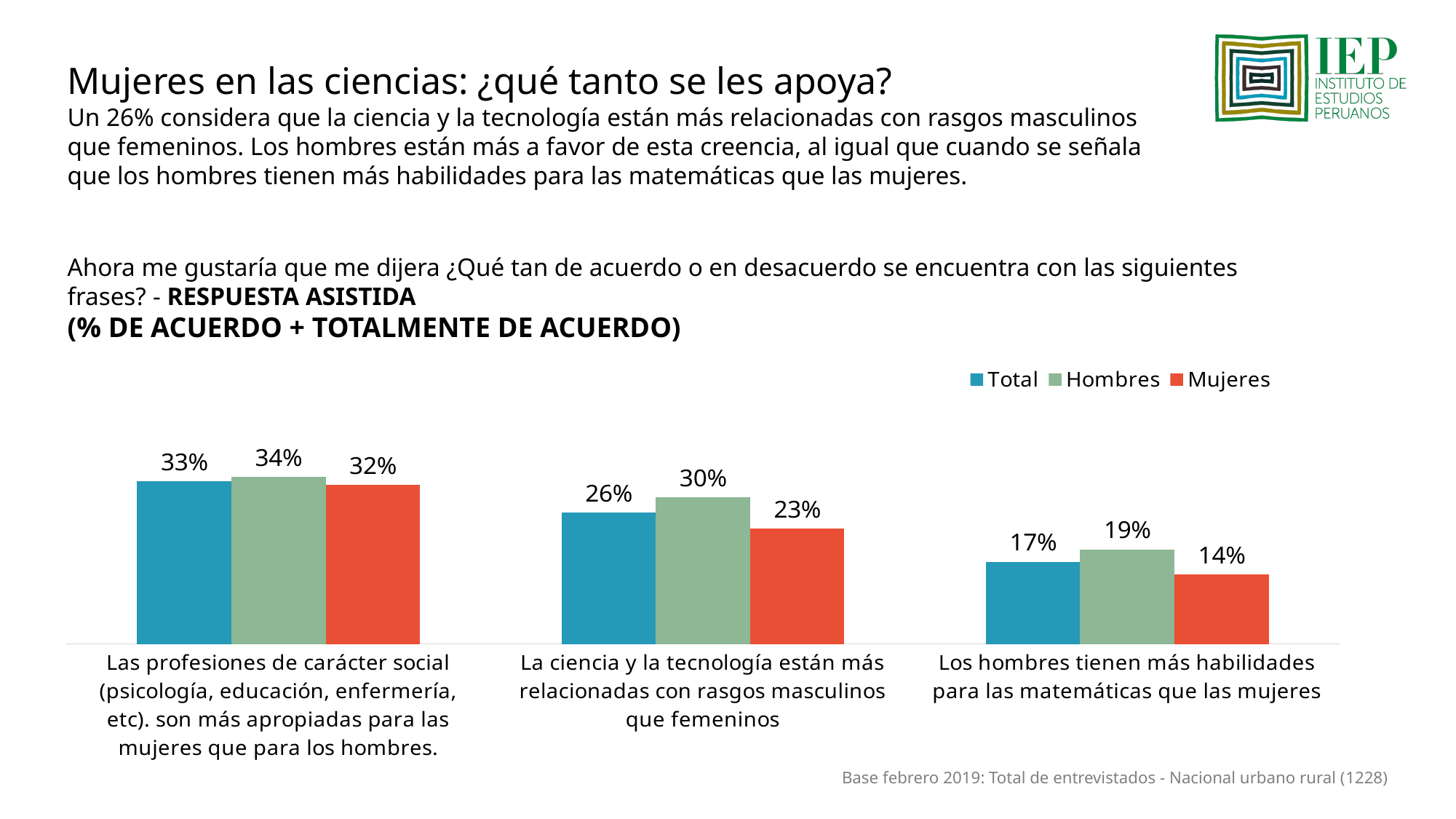
Which statement has the highest Total value? Las profesiones de carácter social (psicología, educación, enfermería, etc). son más apropiadas para las mujeres que para los hombres. What is the Hombres value for the statement that men have more ability for mathematics than women? 19% Which series is shown in red in the chart? Mujeres What kind of chart is shown on the slide? Bar chart What is the difference between the Hombres and Mujeres values for the statement that science and technology are more related to masculine traits? 7 percentage points What is the Total value for the statement that science and technology are more related to masculine traits than feminine ones? 26% For the statement that men have more ability for mathematics than women, which is larger: the Hombres value or the Mujeres value? Hombres How many statements (categories) are shown on the x axis of the chart? 3 Which statement has the lowest Mujeres value? Los hombres tienen más habilidades para las matemáticas que las mujeres How many series does the legend list? 3 What is the Mujeres value for the statement that social professions are more appropriate for women than for men? 32% Do the Total values rise or fall from left to right across the three statements? Fall